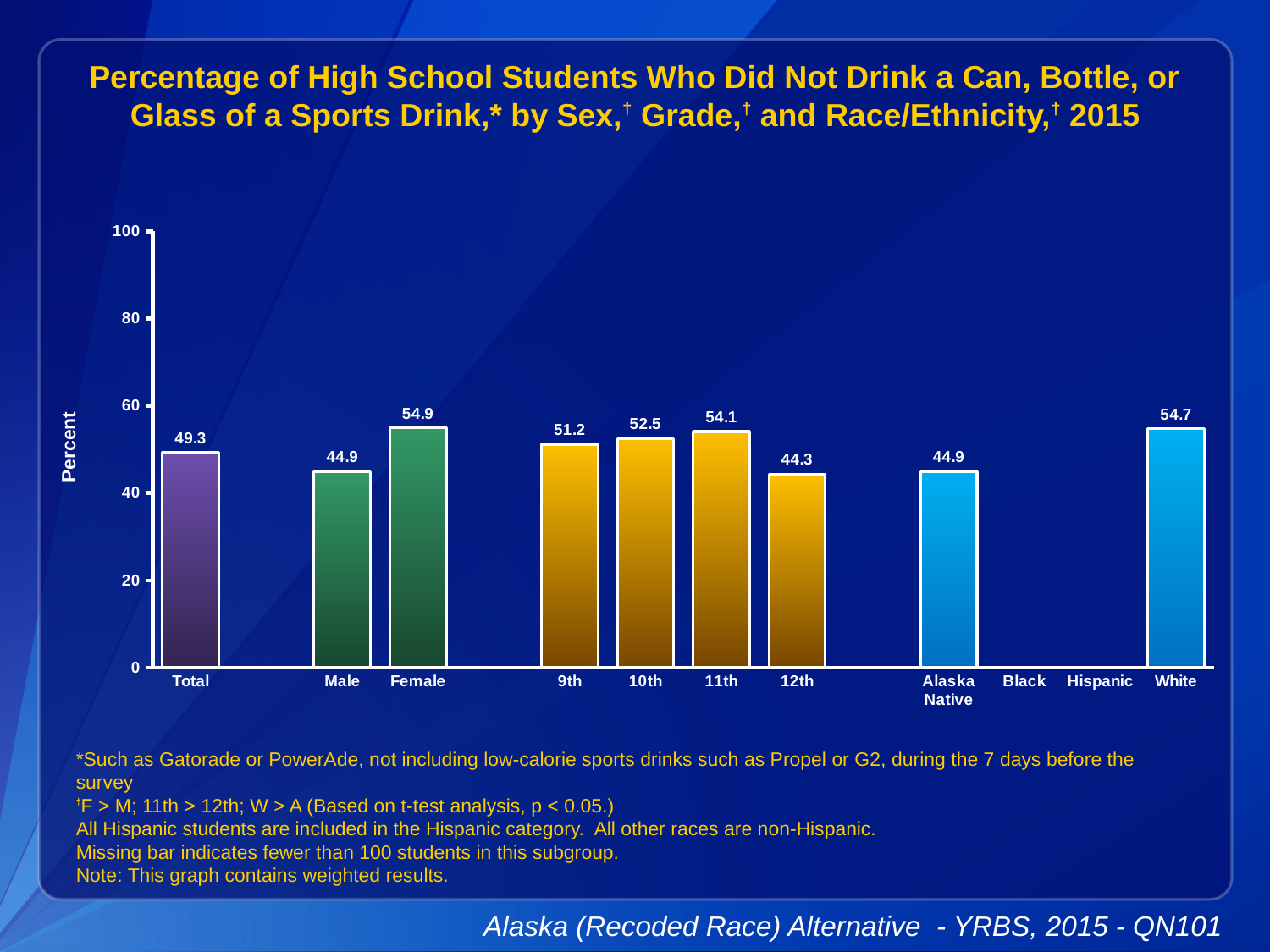
What is the difference between the Female and Male values? 10.0 What is the value for 12th grade? 44.3 What kind of chart is shown on the slide? bar chart What is the difference between the 11th grade and 12th grade values? 9.8 What is the value for Female? 54.9 Is the value for Total greater or less than 40? greater What is the value for White? 54.7 What is the value for Total? 49.3 Which categories on the x axis have no bar plotted? Black and Hispanic How many bars are plotted on the chart? 9 Which is larger, the value for Male or the value for Female? Female Which is larger, the value for Alaska Native or the value for White? White